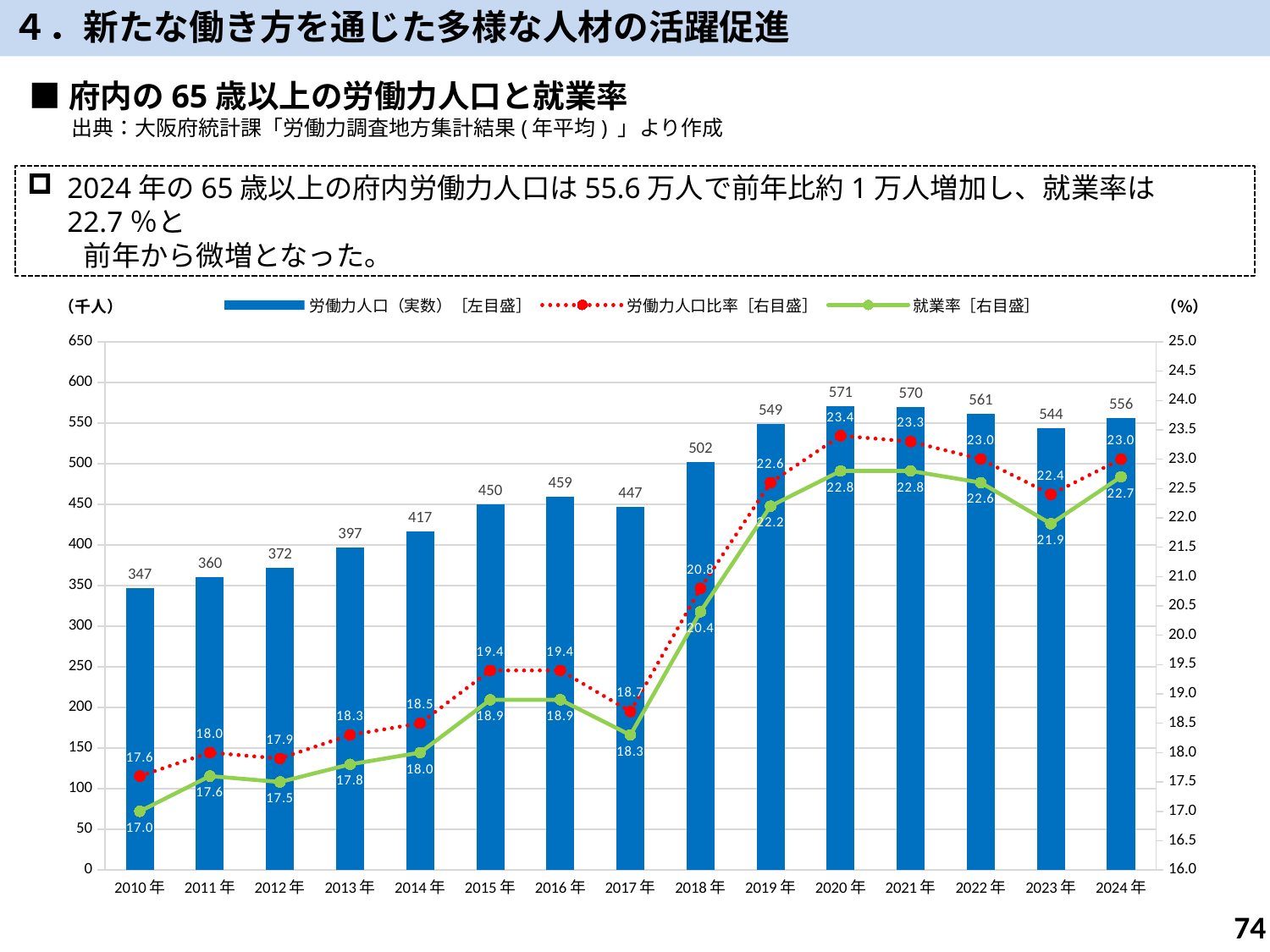
What unit is shown on the left axis label? （千人） Which is larger, the 労働力人口（実数） value for 2018年 or for 2017年? 2018年 What is the 労働力人口（実数） value for 2024年? 556 What is the 労働力人口比率 value for 2020年? 23.4 What kind of chart is this? Combined bar and line chart Which year has the lowest 就業率 value? 2010年 How many years are shown on the x axis? 15 What is the difference between the 労働力人口（実数） values for 2024年 and 2023年? 12 What is the 就業率 value for 2023年? 21.9 How many series does the legend list? 3 Which year has the highest 労働力人口（実数） bar? 2020年 Does the 労働力人口（実数） value rise or fall from 2010年 to 2016年? rise